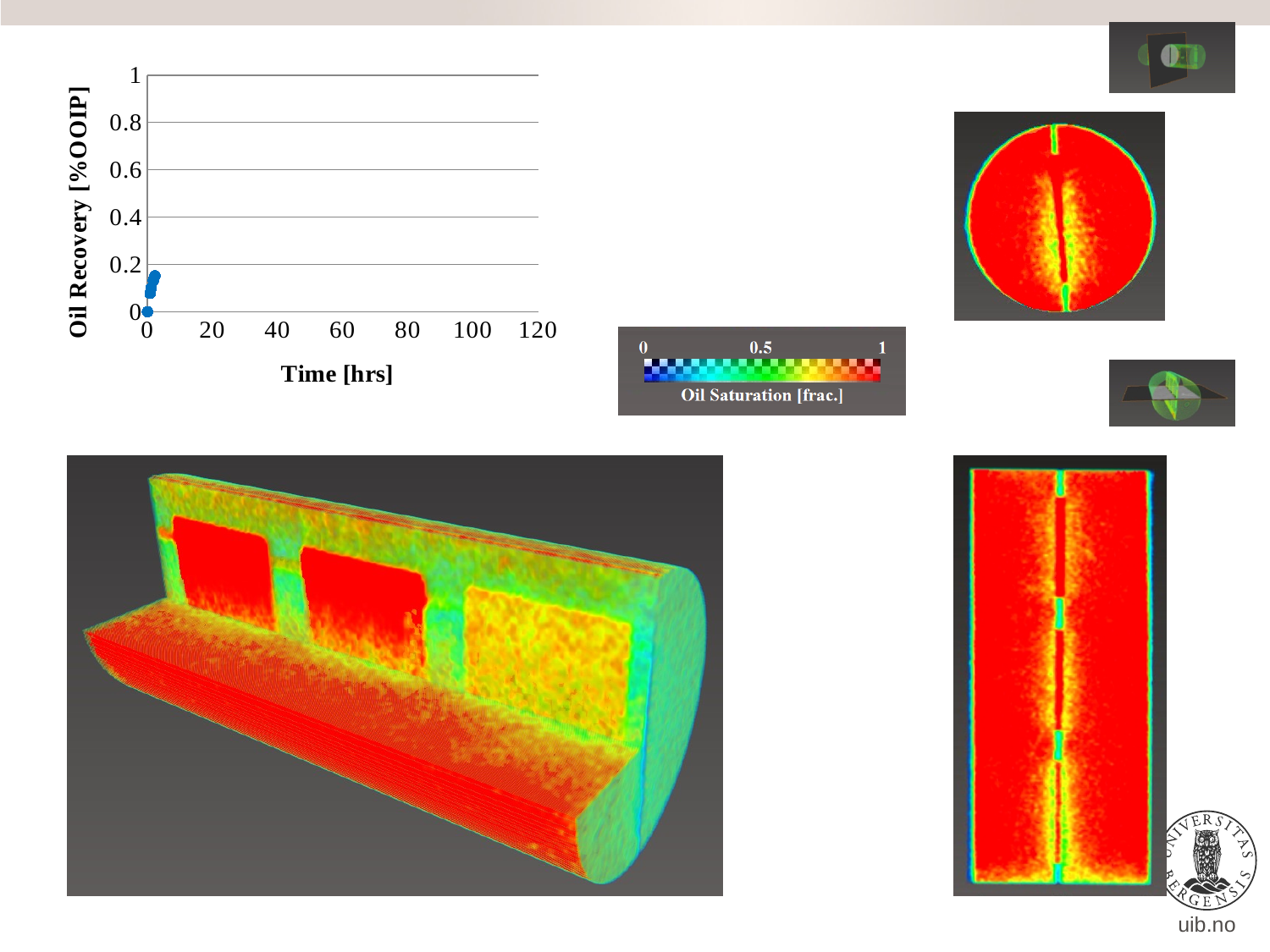
In the Oil Recovery chart, are all plotted oil recovery values greater or less than 0.2? less In the Oil Recovery chart, are the plotted points located at times greater or less than 20 hrs? less What is the label of the x axis of the chart at the top left? Time [hrs] What is the maximum value shown on the x axis of the Oil Recovery chart? 120 What is the label of the y axis of the chart at the top left? Oil Recovery [%OOIP] In the Oil Recovery chart, does oil recovery rise or fall as time increases over the plotted points? rise In the Oil Recovery chart, is the highest plotted oil recovery value greater or less than 0.4? less What kind of chart is shown at the top left of the slide? scatter chart